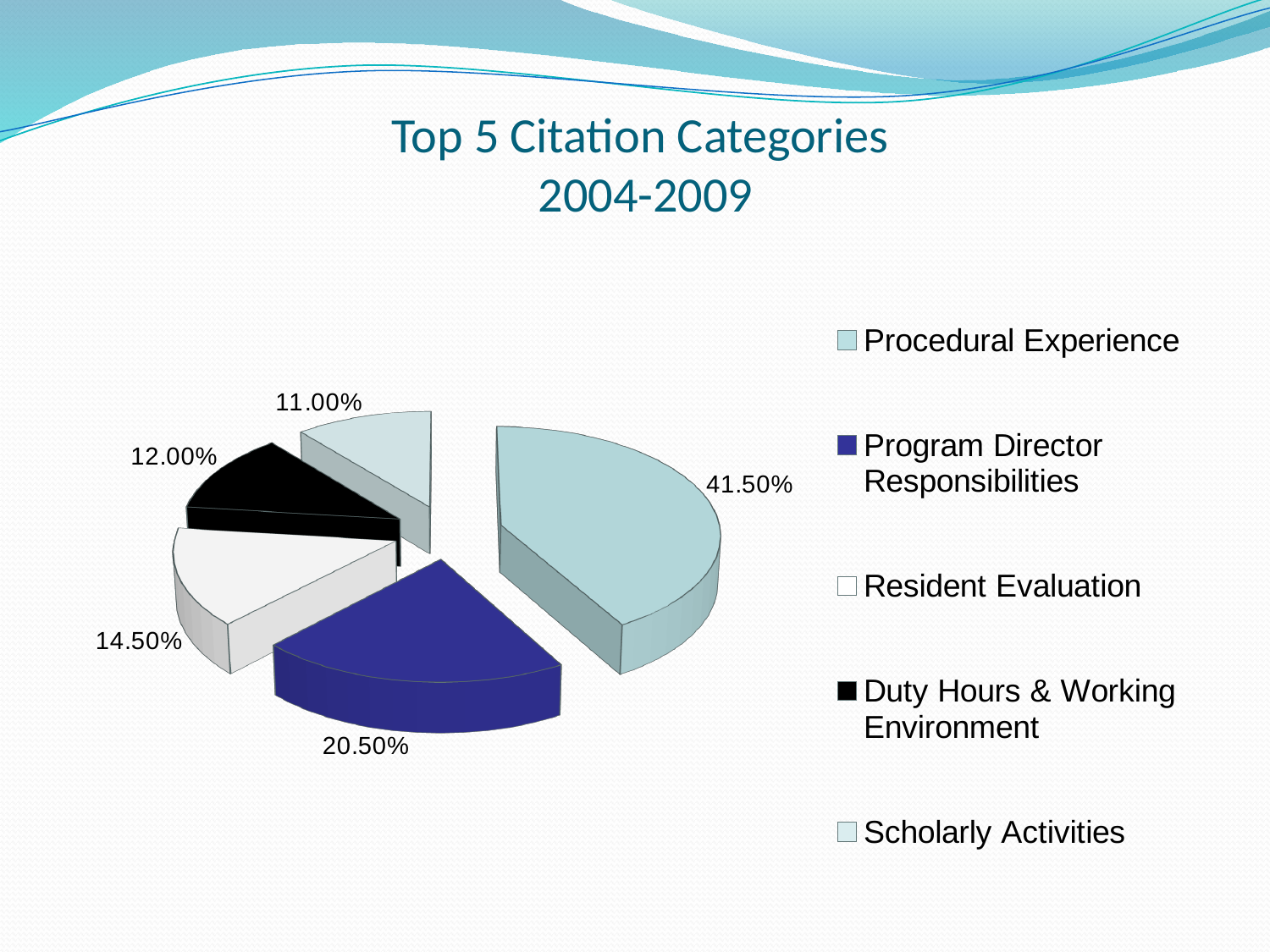
How many categories does the pie chart show? 5 Which citation category has the smallest share of the pie? Scholarly Activities What percentage is shown for Resident Evaluation? 14.50% What is the title of the chart on the slide? Top 5 Citation Categories 2004-2009 What percentage is shown for Scholarly Activities? 11.00% Which is larger, the share for Resident Evaluation or the share for Duty Hours & Working Environment? Resident Evaluation What kind of chart is shown on the slide? Pie chart What share of citations does Procedural Experience account for? 41.50% What percentage is shown for Duty Hours & Working Environment? 12.00% What percentage is shown for Program Director Responsibilities? 20.50% What is the difference in percentage points between Procedural Experience and Program Director Responsibilities? 21.00% Which citation category has the largest share of the pie? Procedural Experience